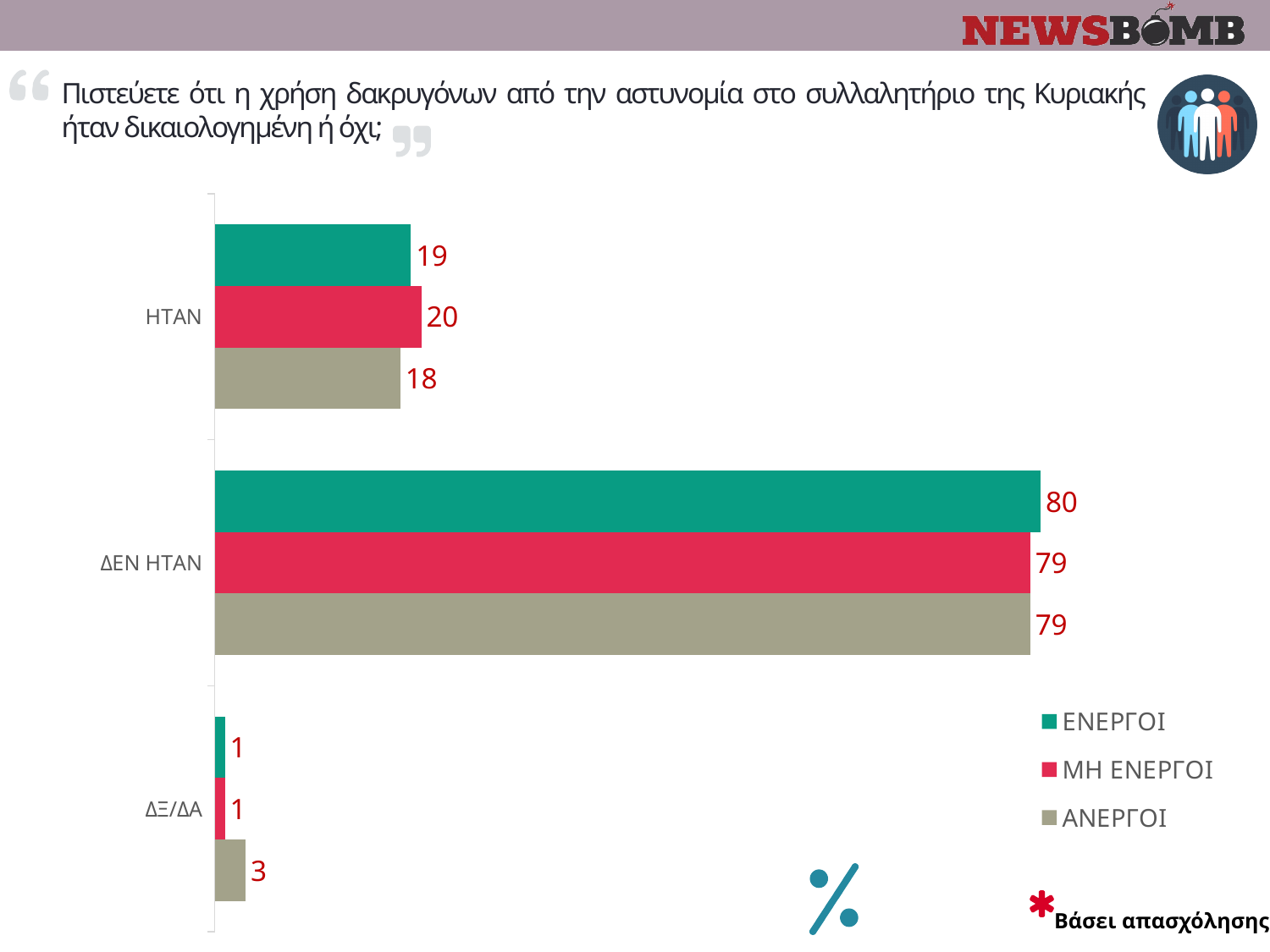
Which series has the lowest value in the ΗΤΑΝ category? ΑΝΕΡΓΟΙ What is the value for ΜΗ ΕΝΕΡΓΟΙ in the ΔΕΝ ΗΤΑΝ category? 79 What is the value for ΑΝΕΡΓΟΙ in the ΗΤΑΝ category? 18 What kind of chart is shown on the slide? Bar chart Which series is shown in red in the legend? ΜΗ ΕΝΕΡΓΟΙ What is the value for ΑΝΕΡΓΟΙ in the ΔΞ/ΔΑ category? 3 Which is larger in the ΔΞ/ΔΑ category: the ΑΝΕΡΓΟΙ value or the ΕΝΕΡΓΟΙ value? ΑΝΕΡΓΟΙ Which series has the highest value in the ΔΕΝ ΗΤΑΝ category? ΕΝΕΡΓΟΙ How many series does the legend list? 3 How many categories are shown on the chart? 3 What is the difference between the ΜΗ ΕΝΕΡΓΟΙ value and the ΑΝΕΡΓΟΙ value in the ΗΤΑΝ category? 2 What is the value for ΕΝΕΡΓΟΙ in the ΗΤΑΝ category? 19